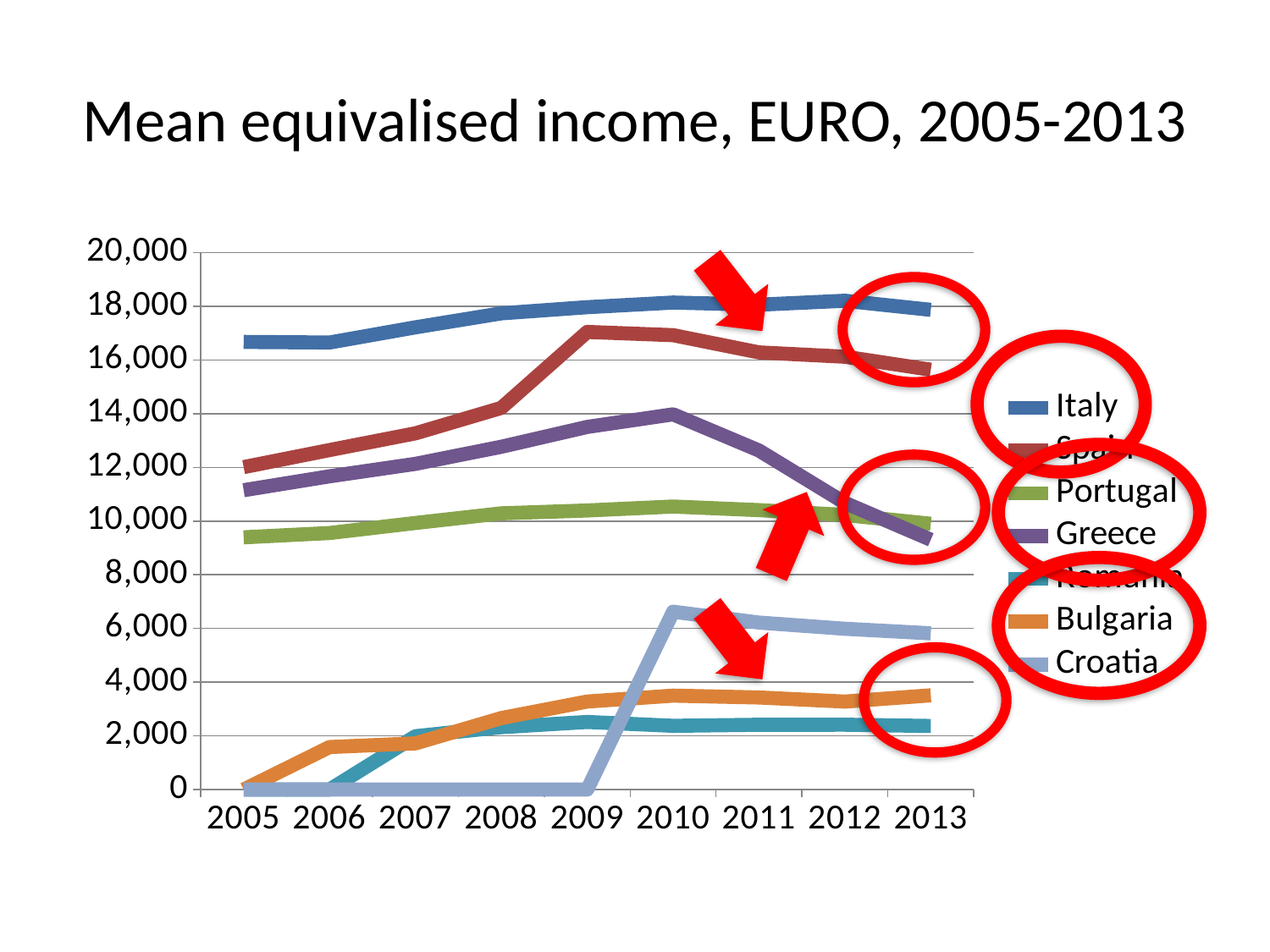
How many series does the legend list? 7 What is the value for Croatia in 2007? 0 Is the value for Bulgaria in 2013 greater or less than 4,000? less Is the value for Greece in 2013 greater or less than 10,000? less What kind of chart is shown on the slide? line chart Which country has the highest mean equivalised income in 2013? Italy Does the value for Greece rise or fall from 2010 to 2013? fall Is the value for Italy in 2013 greater or less than 16,000? greater In 2013, which is larger: the value for Croatia or the value for Bulgaria? Croatia How many years are shown along the x axis? 9 What is the title of the chart? Mean equivalised income, EURO, 2005-2013